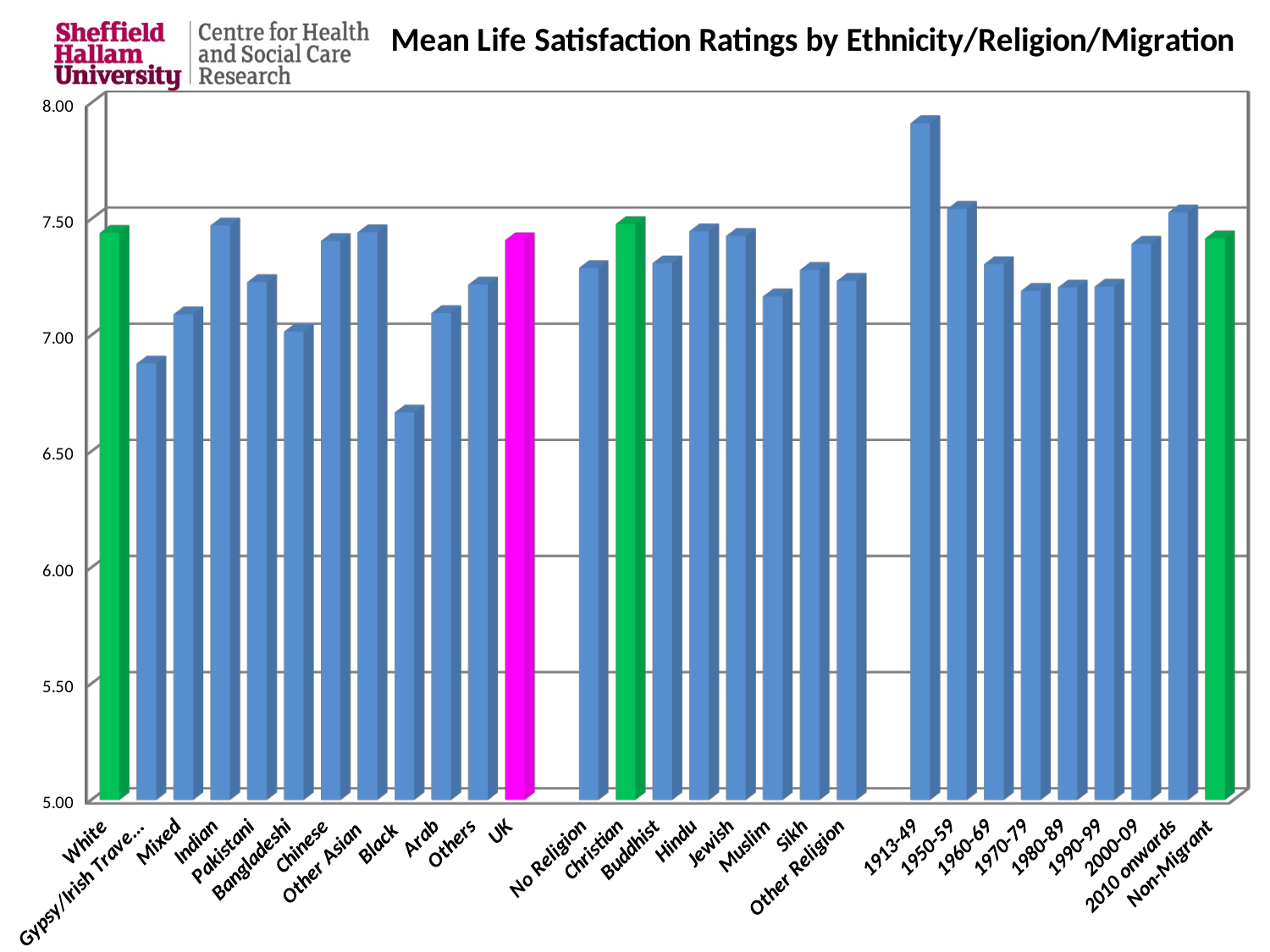
Is the value for Black greater or less than 7.00? less Which has a higher mean life satisfaction rating, Jewish or Muslim? Jewish Which has a higher mean life satisfaction rating, Indian or Black? Indian Which category has the highest mean life satisfaction rating? 1913-49 Is the value for 1913-49 greater or less than 7.50? greater Is the value for Muslim greater or less than 7.50? less Which has a higher mean life satisfaction rating, 1913-49 or 1950-59? 1913-49 What colour is the bar for UK? Magenta Which category has the lowest mean life satisfaction rating? Black What is the title of the chart? Mean Life Satisfaction Ratings by Ethnicity/Religion/Migration What type of chart is shown on the slide? Bar chart